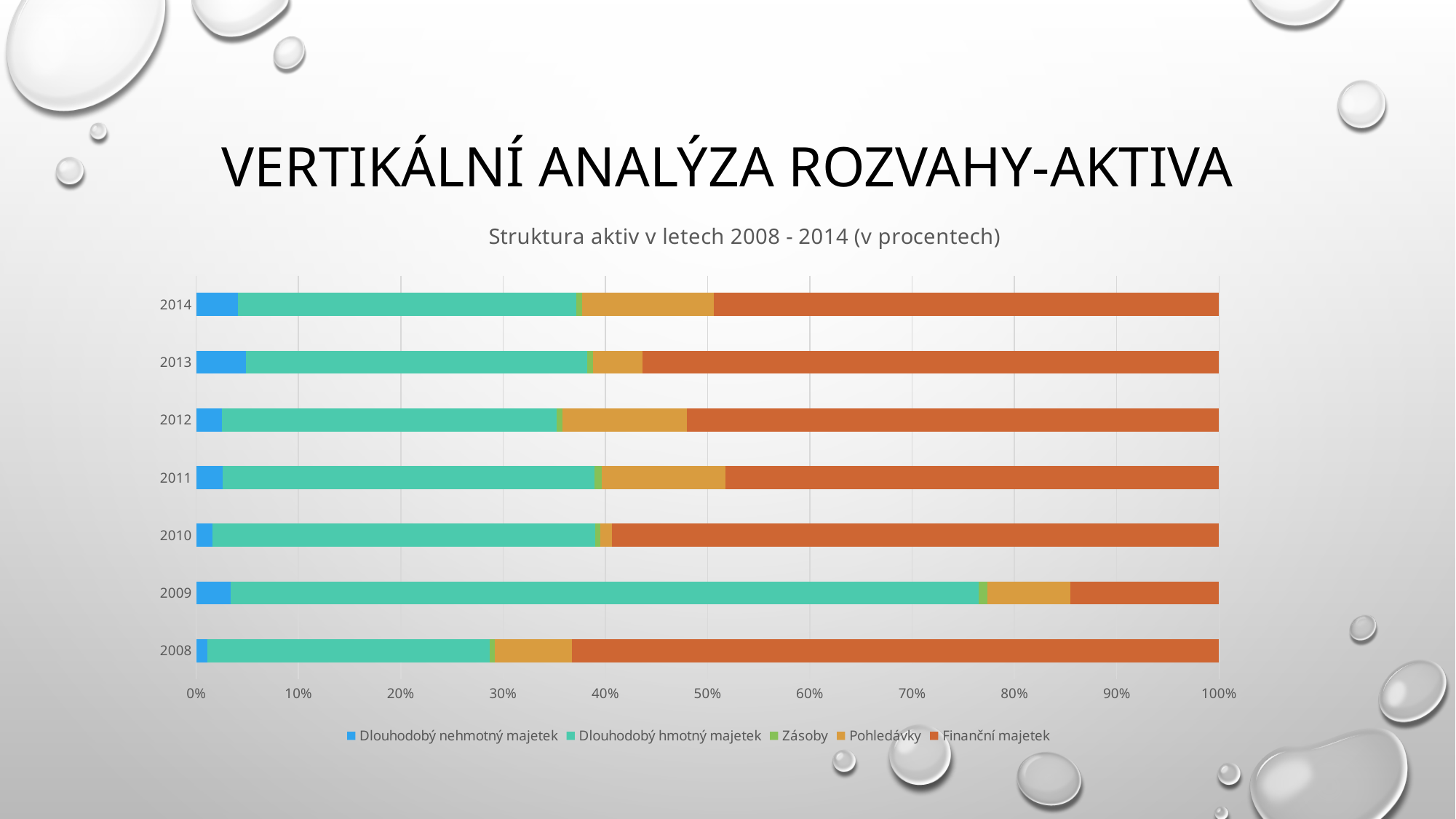
Is the share of Finanční majetek in 2009 greater or less than 20%? less In which year is the share of Dlouhodobý hmotný majetek the lowest? 2008 Is the share of Dlouhodobý hmotný majetek in 2009 greater or less than 70%? greater What kind of chart is shown on the slide? Stacked bar chart How many series does the legend list? 5 How many years (categories) are plotted on the chart? 7 Which series is shown in orange-red (the last legend entry)? Finanční majetek Is the share of Finanční majetek in 2013 greater or less than 50%? greater In which year is the share of Dlouhodobý hmotný majetek the highest? 2009 What is the total of each stacked bar on the chart? 100% Which year has the larger share of Pohledávky, 2012 or 2013? 2012 What is the title of the chart? Struktura aktiv v letech 2008 - 2014 (v procentech)